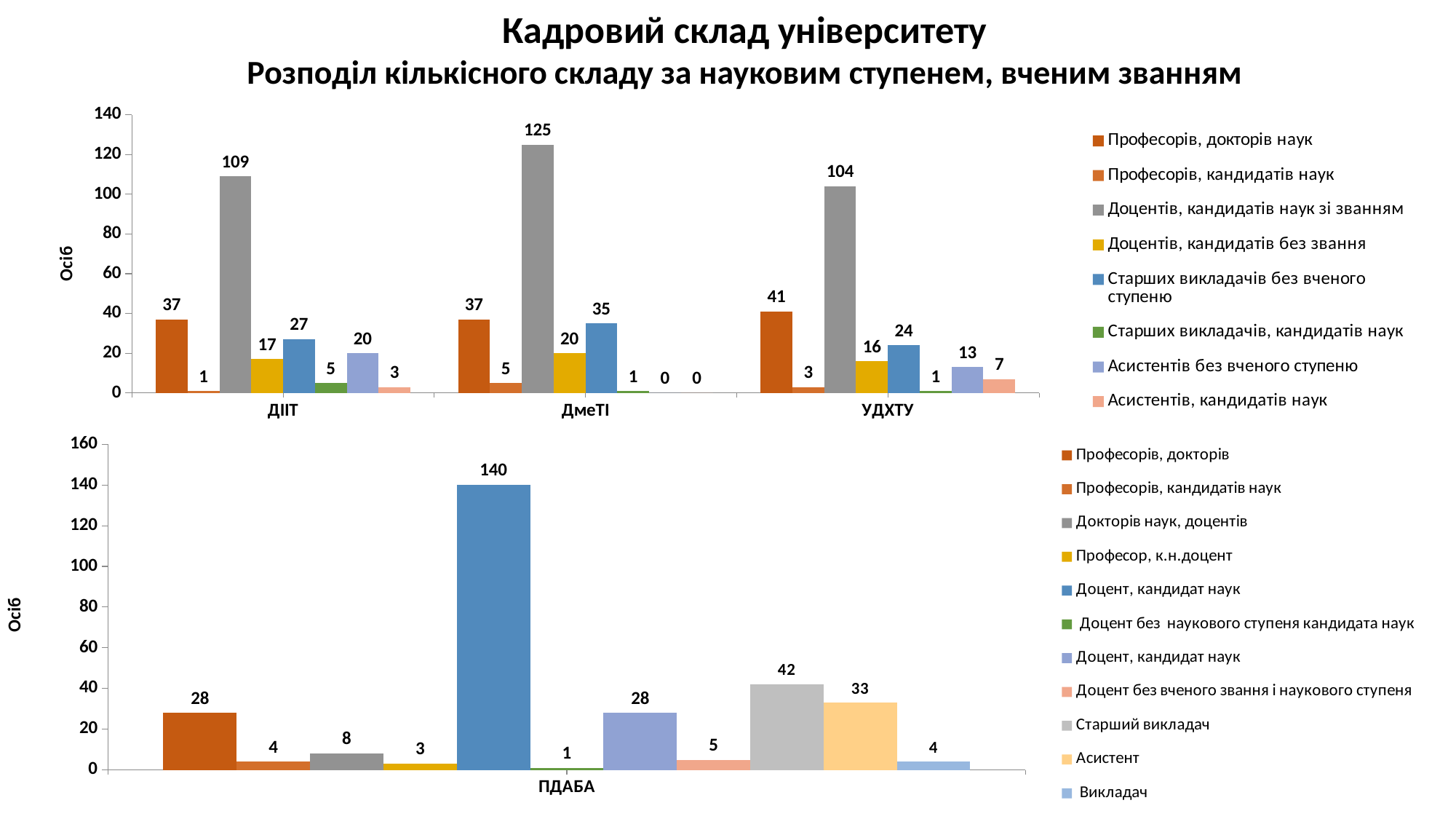
In the bottom chart (ПДАБА), what is the difference between the Старший викладач and Асистент values? 9 How many series does the legend of the top chart list? 8 What type of chart is the bottom chart? Bar chart In the bottom chart (ПДАБА), what is the value for Старший викладач? 42 In the top chart, what is the value for Професорів, докторів наук at УДХТУ? 41 In the top chart, which institution has the lowest number of Старших викладачів без вченого ступеню? УДХТУ In the top chart, which is larger: Асистентів без вченого ступеню at ДІІТ or at УДХТУ? ДІІТ In the top chart, which institution has the highest number of Доцентів, кандидатів наук зі званням? ДмеТІ In the top chart, how many institutions are shown on the x axis? 3 In the bottom chart (ПДАБА), what is the value for Асистент? 33 In the top chart, what is the difference between the Доцентів, кандидатів наук зі званням values at ДмеТІ and УДХТУ? 21 In the top chart, how many Доцентів, кандидатів наук зі званням are there at ДмеТІ? 125